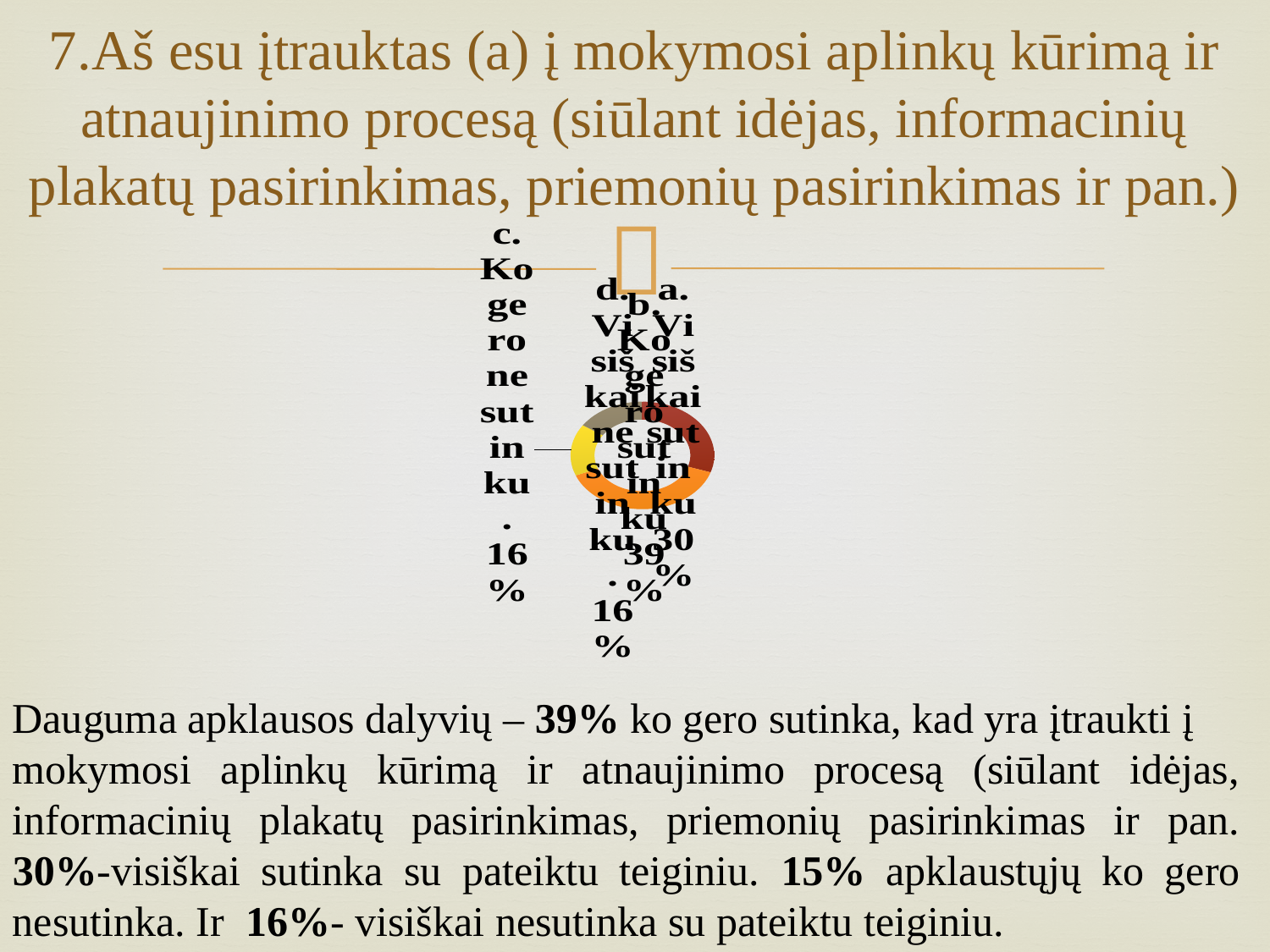
What percentage is shown for "a. Visiškai sutinku"? 30% What share of the chart does the largest slice represent? 39% Which is larger, the slice for "c. Ko gero nesutinku" or the slice for "a. Visiškai sutinku"? a. Visiškai sutinku What kind of chart is shown on the slide? doughnut chart Which category has the largest slice in the chart? b. Ko gero sutinku Which is larger, the slice for "a. Visiškai sutinku" or the slice for "b. Ko gero sutinku"? b. Ko gero sutinku What percentage is shown for "b. Ko gero sutinku"? 39% How many slices does the doughnut chart have? 4 What percentage is shown for "c. Ko gero nesutinku"? 16% What is the difference in percentage points between "b. Ko gero sutinku" and "a. Visiškai sutinku"? 9